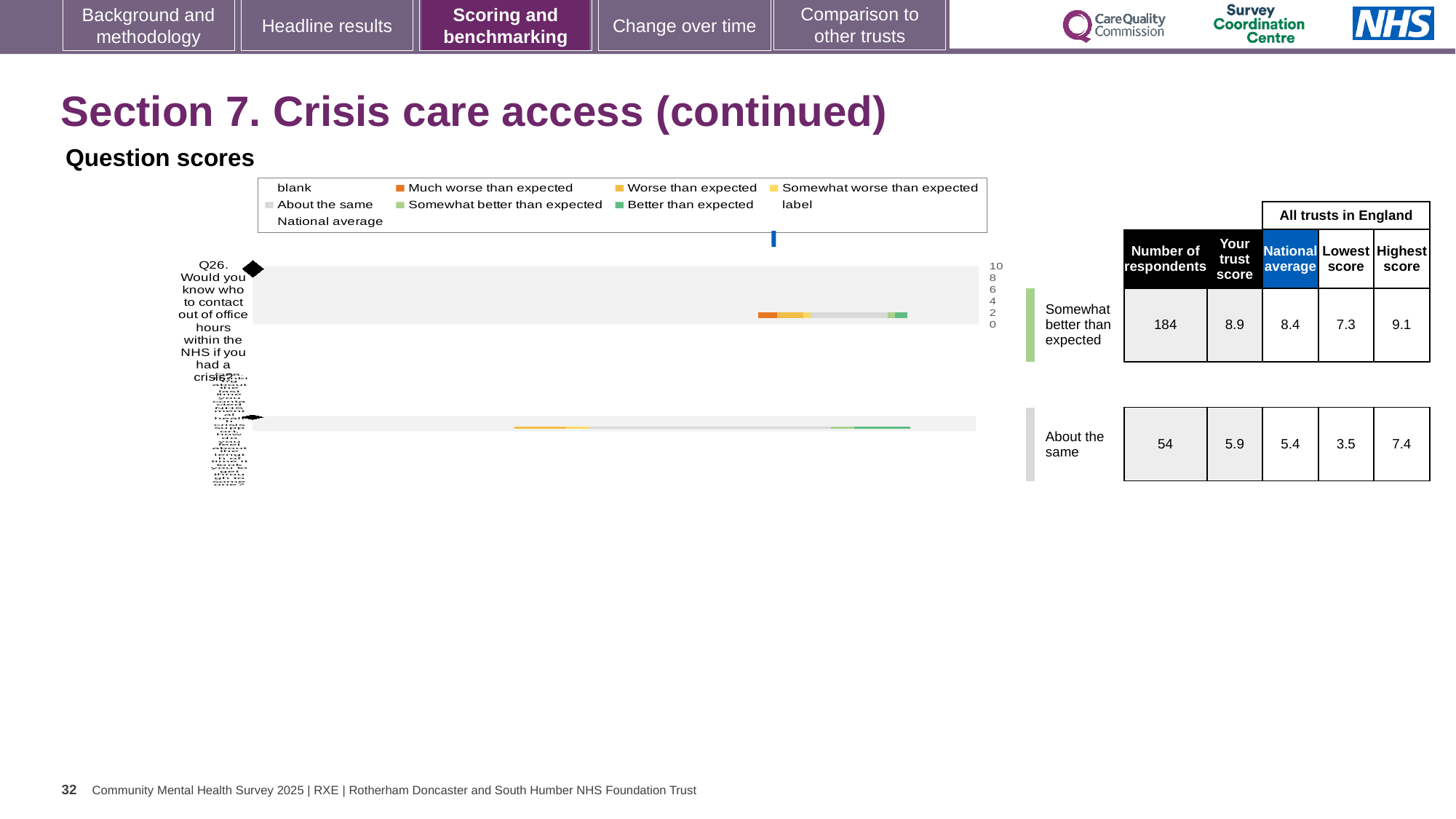
What is the trust score for the second question row on the chart? 5.9 What is the highest score among all trusts in England for Q26? 9.1 What kind of chart is used to show the question scores? Bar chart What is the national average score for Q26? 8.4 How many respondents answered the second question row on the chart? 54 What is the trust score for Q26 (Would you know who to contact out of office hours within the NHS if you had a crisis?)? 8.9 What benchmark category is shown for the second question row on the chart? About the same For Q26, which is larger: the trust score or the national average? The trust score (8.9) For Q26, what is the difference between the highest and lowest scores among all trusts in England? 1.8 What is the lowest score among all trusts in England for Q26? 7.3 What benchmark category is shown for Q26? Somewhat better than expected How many respondents answered Q26? 184